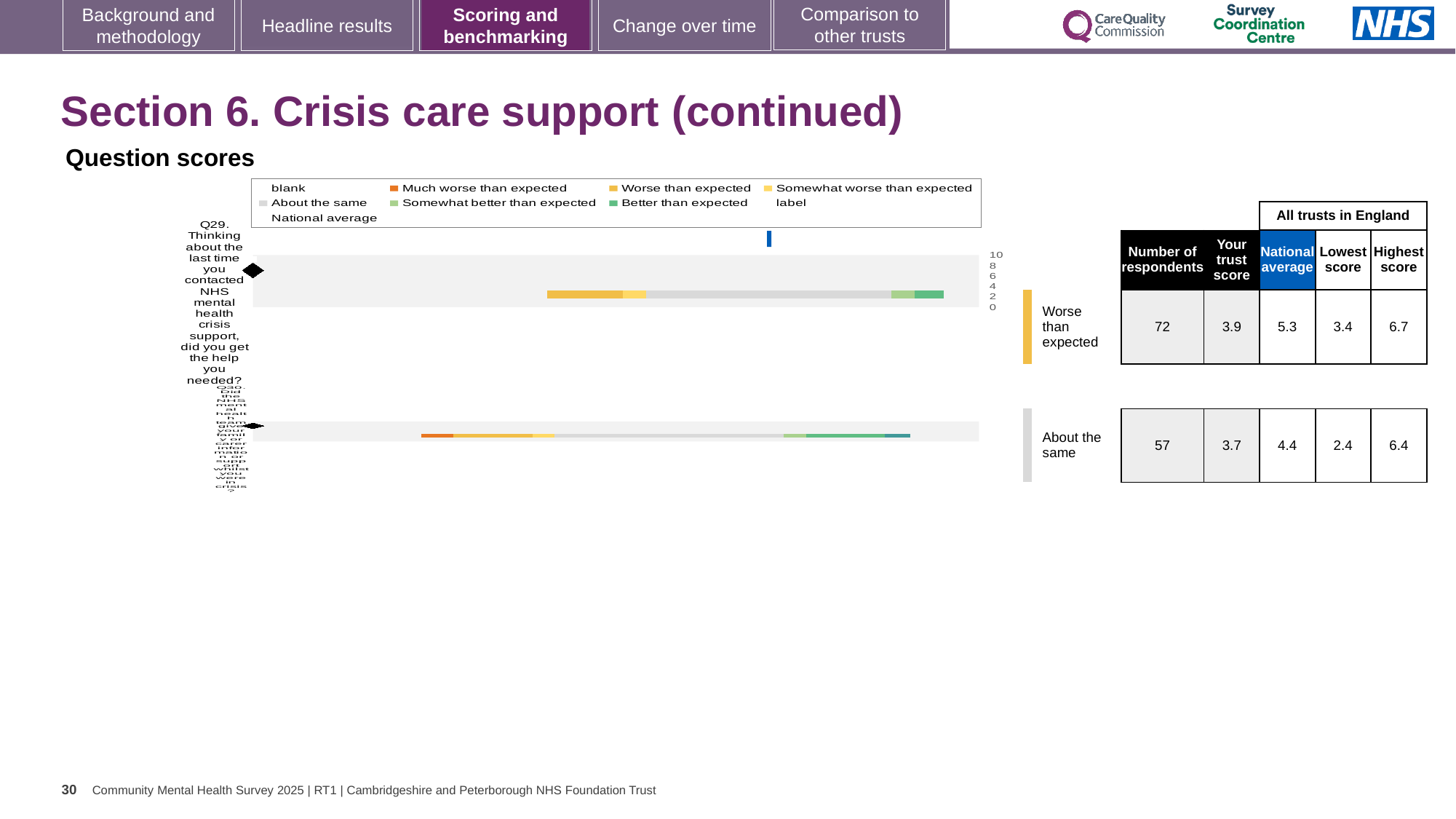
What is the highest value shown on the score axis of the chart? 10 Which two questions are plotted in the question scores chart? Q29 and Q30 How many questions are plotted in the question scores chart? 2 What is the difference between the national average and the trust score for Q29? 1.4 What is the lowest score across all trusts in England for Q30? 2.4 What is the national average for Q30 in the table next to the chart? 4.4 Which question has the higher trust score, Q29 or Q30? Q29 What is the difference between the highest and lowest scores across all trusts for Q30? 4.0 How is the trust's result for Q29 categorised relative to expectation? Worse than expected What is the trust score for Q29 in the table next to the chart? 3.9 How many respondents answered Q29 according to the table? 72 What kind of chart is used to show the question scores on this slide? bar chart